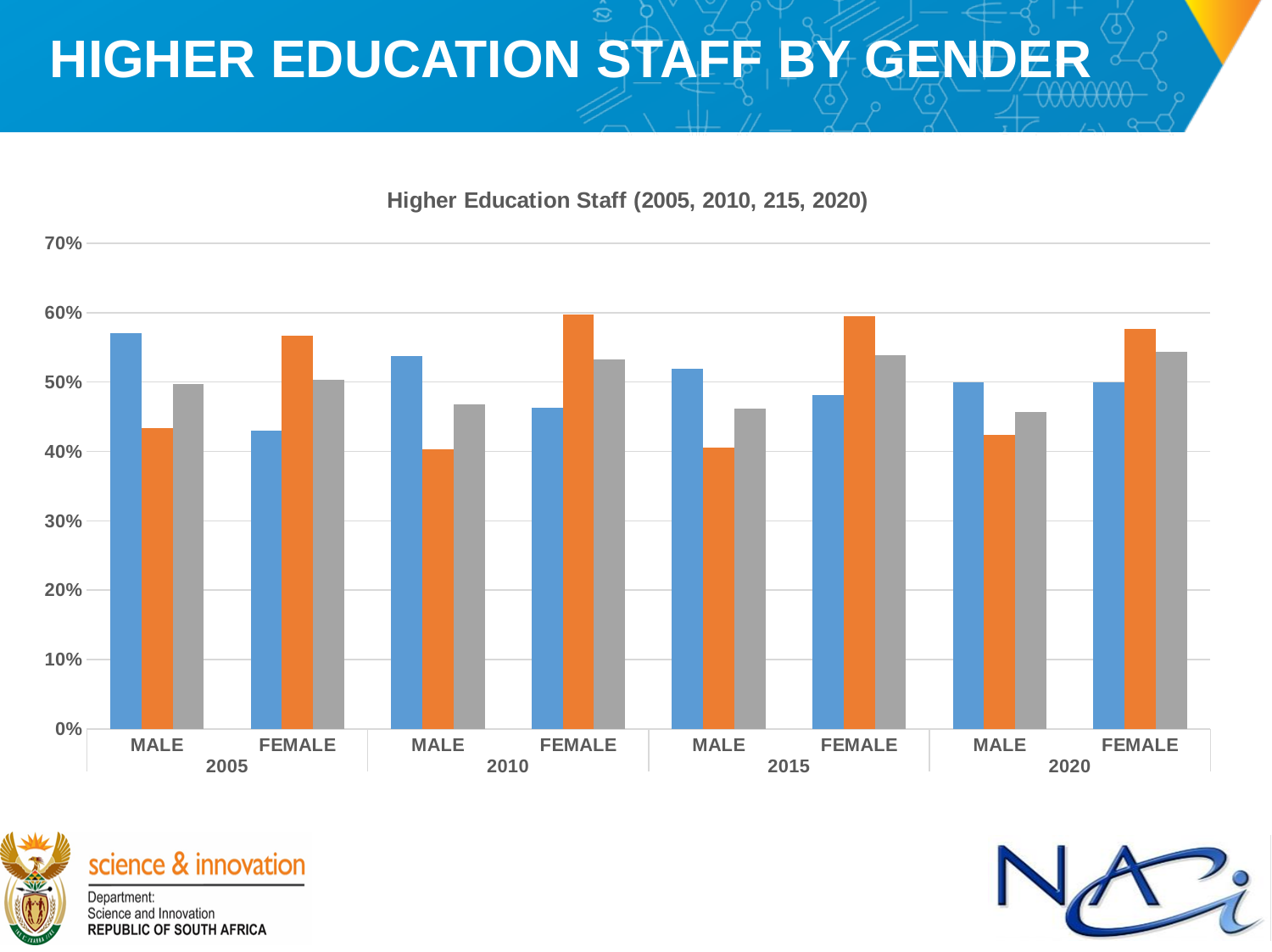
For FEMALE in 2010, which coloured bar is the tallest? the orange bar For MALE in 2005, which is larger: the blue bar or the orange bar? the blue bar Is the value of the grey bar for FEMALE in 2015 greater or less than 50%? greater How many year groups are shown along the x axis of the chart? 4 Is the value of the grey bar for MALE in 2010 greater or less than 50%? less What is the title of the chart? Higher Education Staff (2005, 2010, 215, 2020) Is the value of the blue bar for MALE in 2005 greater or less than 50%? greater What kind of chart is shown on the slide? bar chart How many bars are plotted for each MALE or FEMALE category in the chart? 3